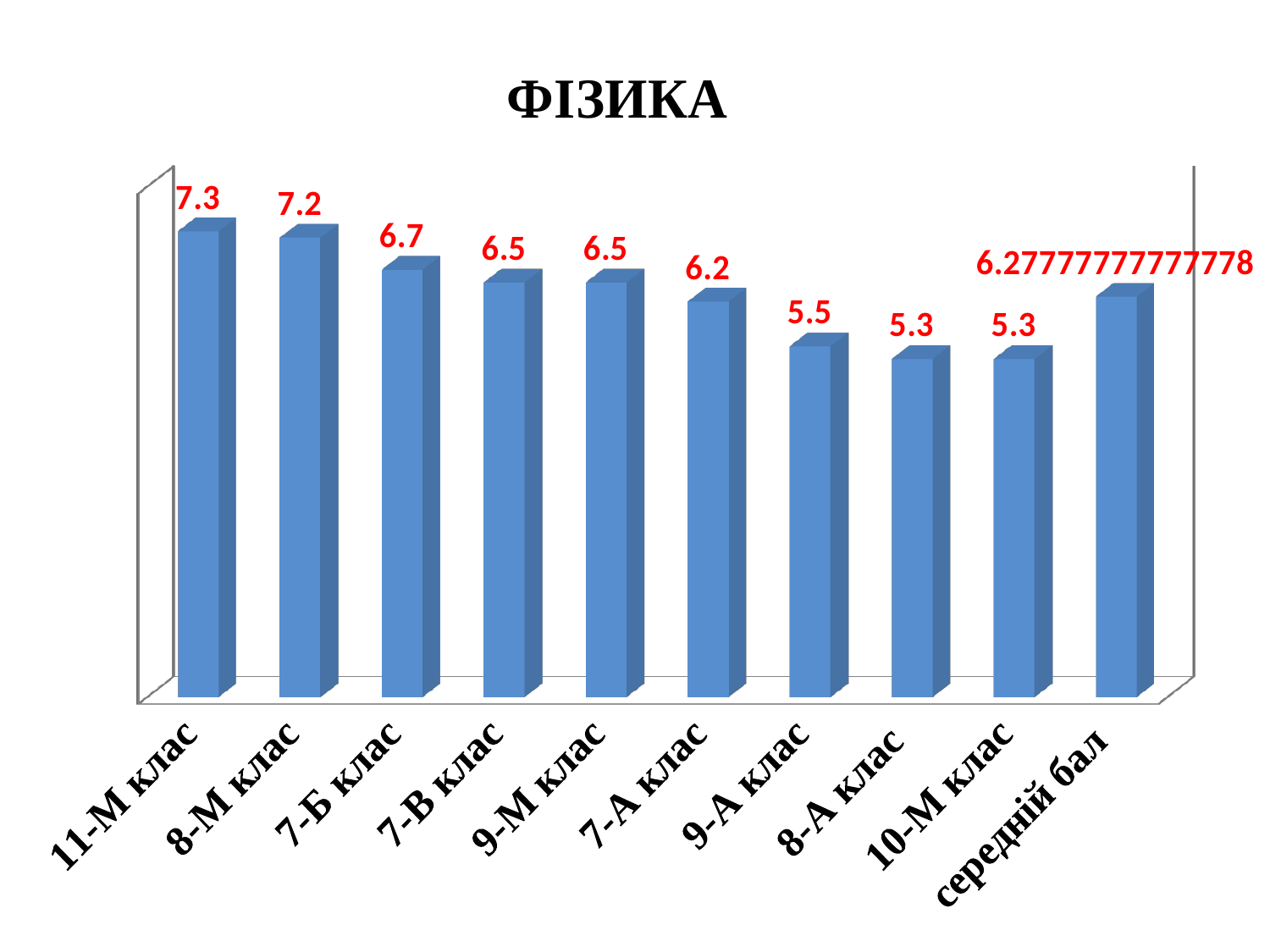
Which is larger, the value for 7-Б клас or the value for 9-А клас? 7-Б клас What value is shown for середній бал? 6.27777777777778 What is the difference between the values for 11-М клас and 10-М клас? 2 What is the value for 7-Б клас? 6.7 What kind of chart is this? bar chart What is the value for 11-М клас? 7.3 How many bars are shown in the chart? 10 What is the title of the chart? ФІЗИКА What is the difference between the values for 8-М клас and 7-А клас? 1 What is the value for 9-А клас? 5.5 Which class has the highest value? 11-М клас Do the values for the classes rise or fall from 11-М клас to 10-М клас? fall